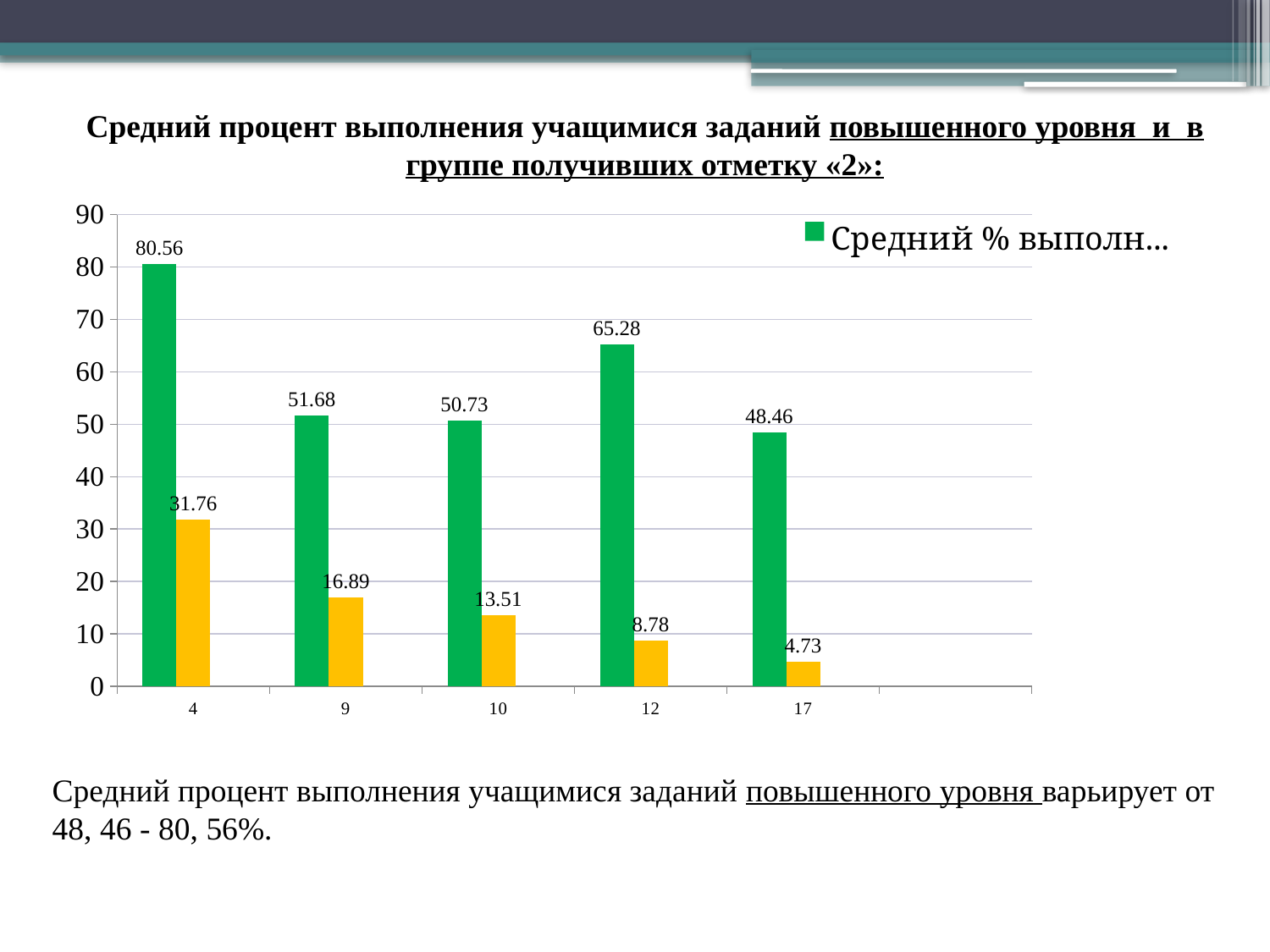
Which category has the lowest yellow bar? 17 How many categories are shown on the x axis? 5 Which category has the highest green bar? 4 What is the difference between the green bar and the yellow bar for category 10? 37.22 What is the value of the yellow bar for category 9? 16.89 What is the value of the green bar for category 4? 80.56 What is the value of the yellow bar for category 12? 8.78 Is the yellow bar for category 4 greater or less than 30? greater Do the yellow bars rise or fall from category 4 to category 17? fall Which is larger: the green bar for category 9 or the green bar for category 12? category 12 What kind of chart is shown on the slide? bar chart What is the value of the green bar for category 17? 48.46